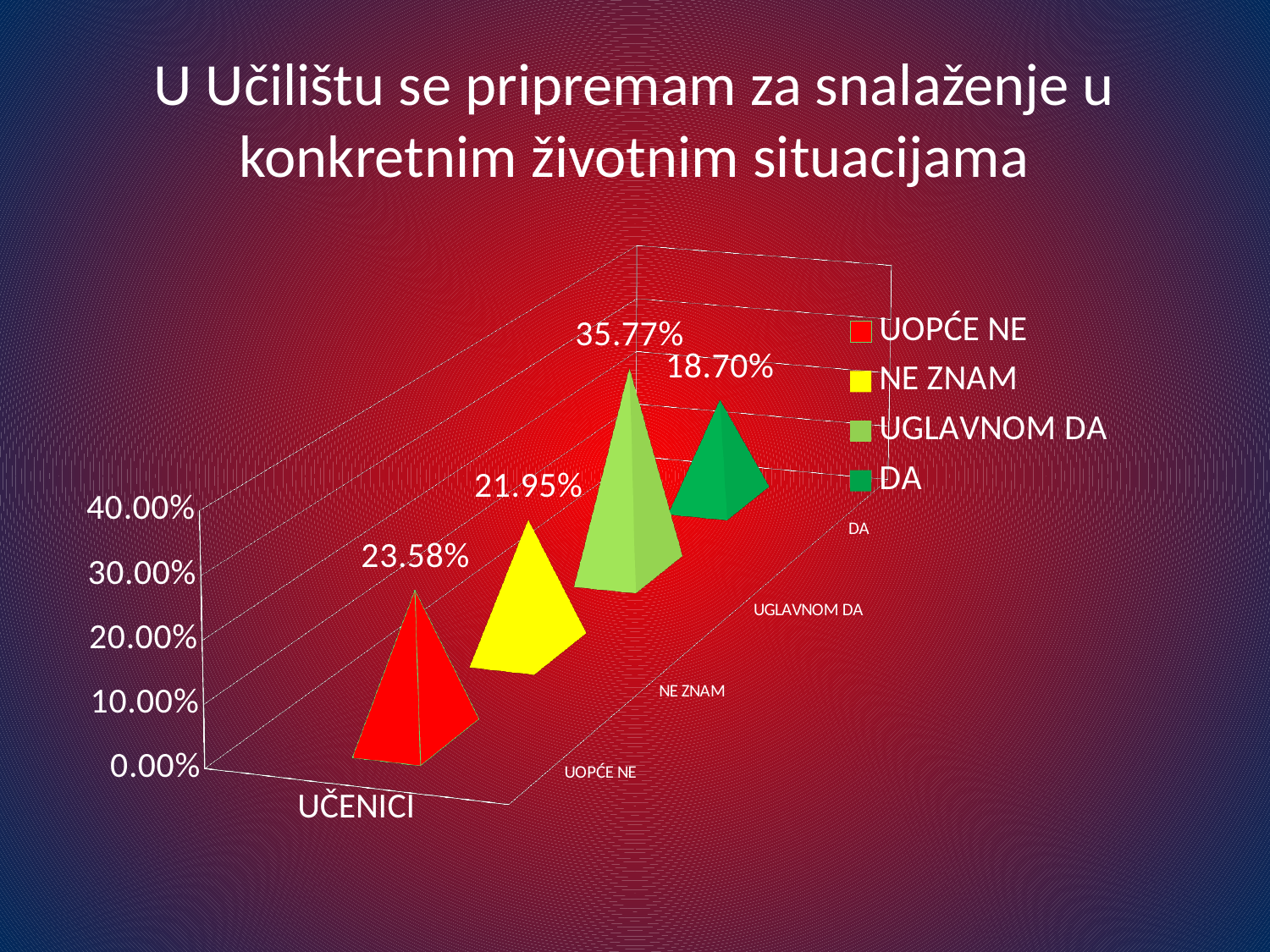
Which response has the lowest value? DA What is the category label shown on the horizontal axis? UČENICI What kind of chart is shown on the slide? bar chart How many series does the legend list? 4 What is the value for NE ZNAM? 21.95% Which response has the highest value? UGLAVNOM DA What is the value for UGLAVNOM DA? 35.77% Which is larger, the value for UOPĆE NE or the value for NE ZNAM? UOPĆE NE What is the value for UOPĆE NE? 23.58% What is the value for DA? 18.70% Is the value for UGLAVNOM DA greater or less than 30.00%? greater What is the difference between the values for UGLAVNOM DA and DA? 17.07%